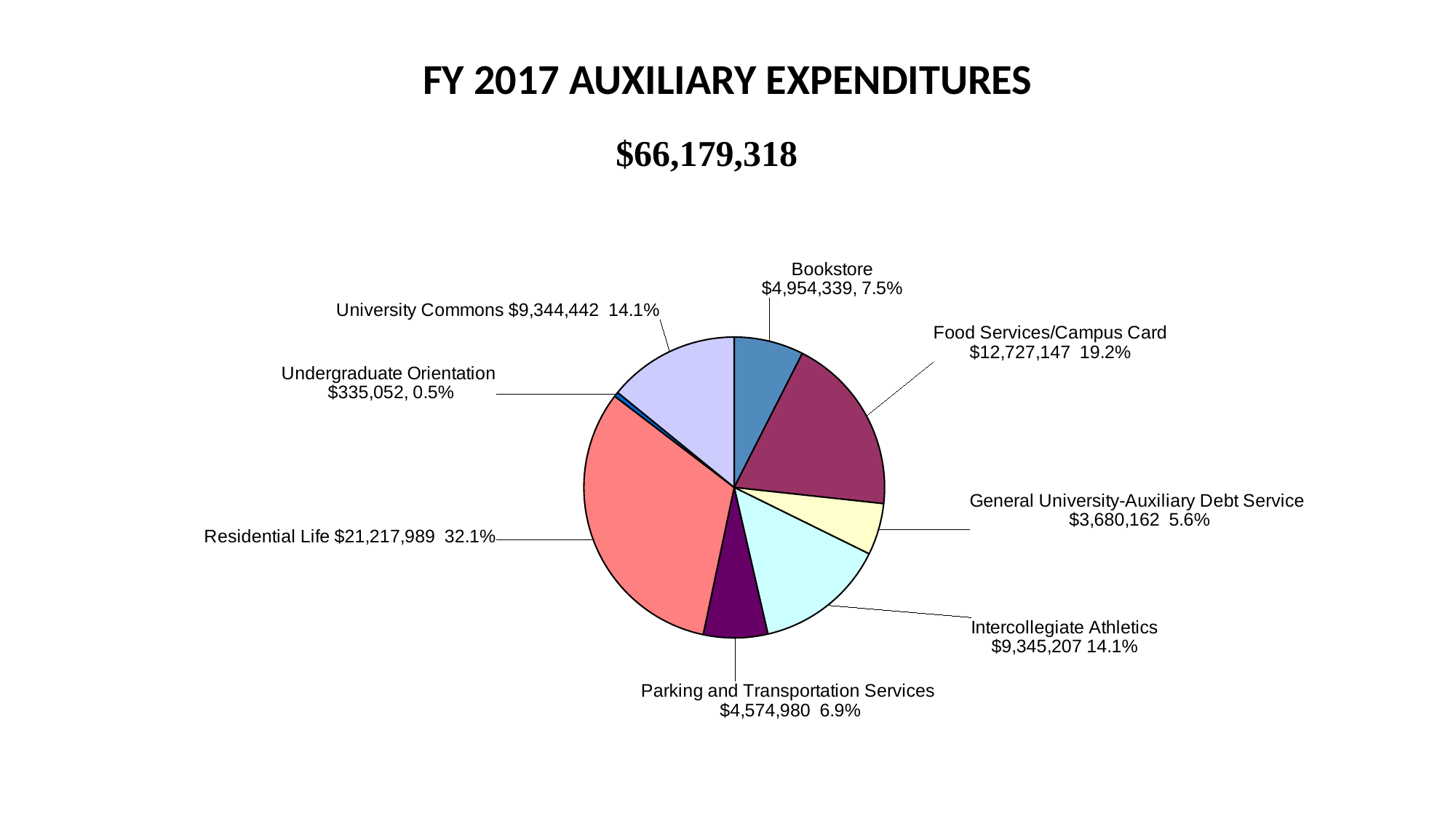
Which is larger, Bookstore or Parking and Transportation Services? Bookstore Which category has the largest slice of the pie? Residential Life Which category has the smallest slice of the pie? Undergraduate Orientation What is the dollar amount for General University-Auxiliary Debt Service? $3,680,162 What is the difference in dollars between Residential Life and Food Services/Campus Card? $8,490,842 How many categories are shown in the pie chart? 8 What is the title of the chart? FY 2017 AUXILIARY EXPENDITURES What kind of chart is shown on the slide? Pie chart What percentage of the pie does Food Services/Campus Card represent? 19.2% What is the dollar amount for Residential Life? $21,217,989 What is the total amount shown below the chart title? $66,179,318 What is the difference in dollars between Food Services/Campus Card and Bookstore? $7,772,808